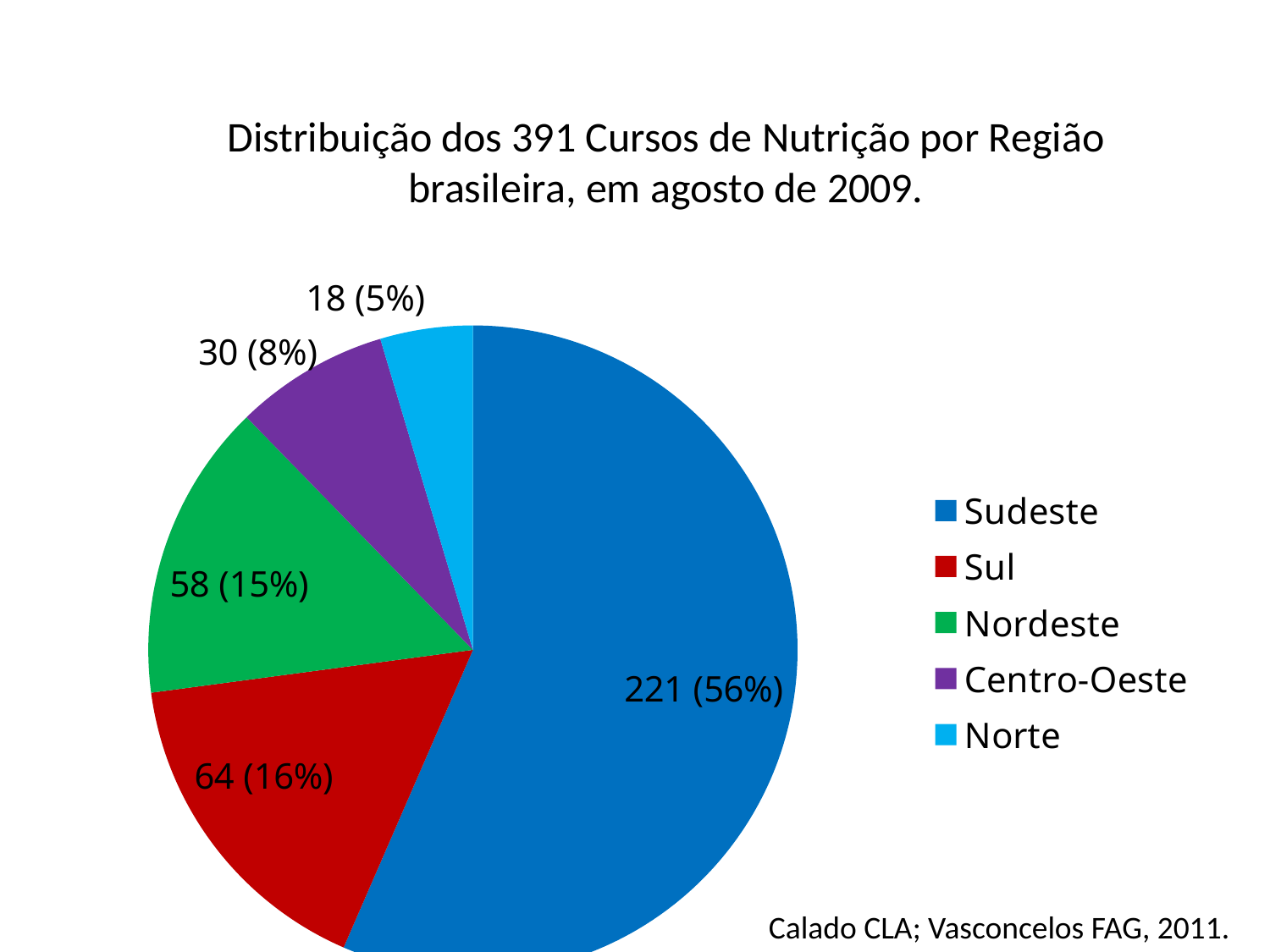
What kind of chart is shown on the slide? pie chart Which region has the smallest slice? Norte How many courses does the Norte slice represent? 18 How many regions does the legend list? 5 What percentage share does the Centro-Oeste slice have? 8% How many courses does the Nordeste slice represent? 58 How many courses does the Sudeste slice represent? 221 What is the difference in number of courses between Sudeste and Sul? 157 What is the title of the chart? Distribuição dos 391 Cursos de Nutrição por Região brasileira, em agosto de 2009. What percentage share does the Sul slice have? 16% Which has more courses, Centro-Oeste or Norte? Centro-Oeste Which region has the largest slice? Sudeste